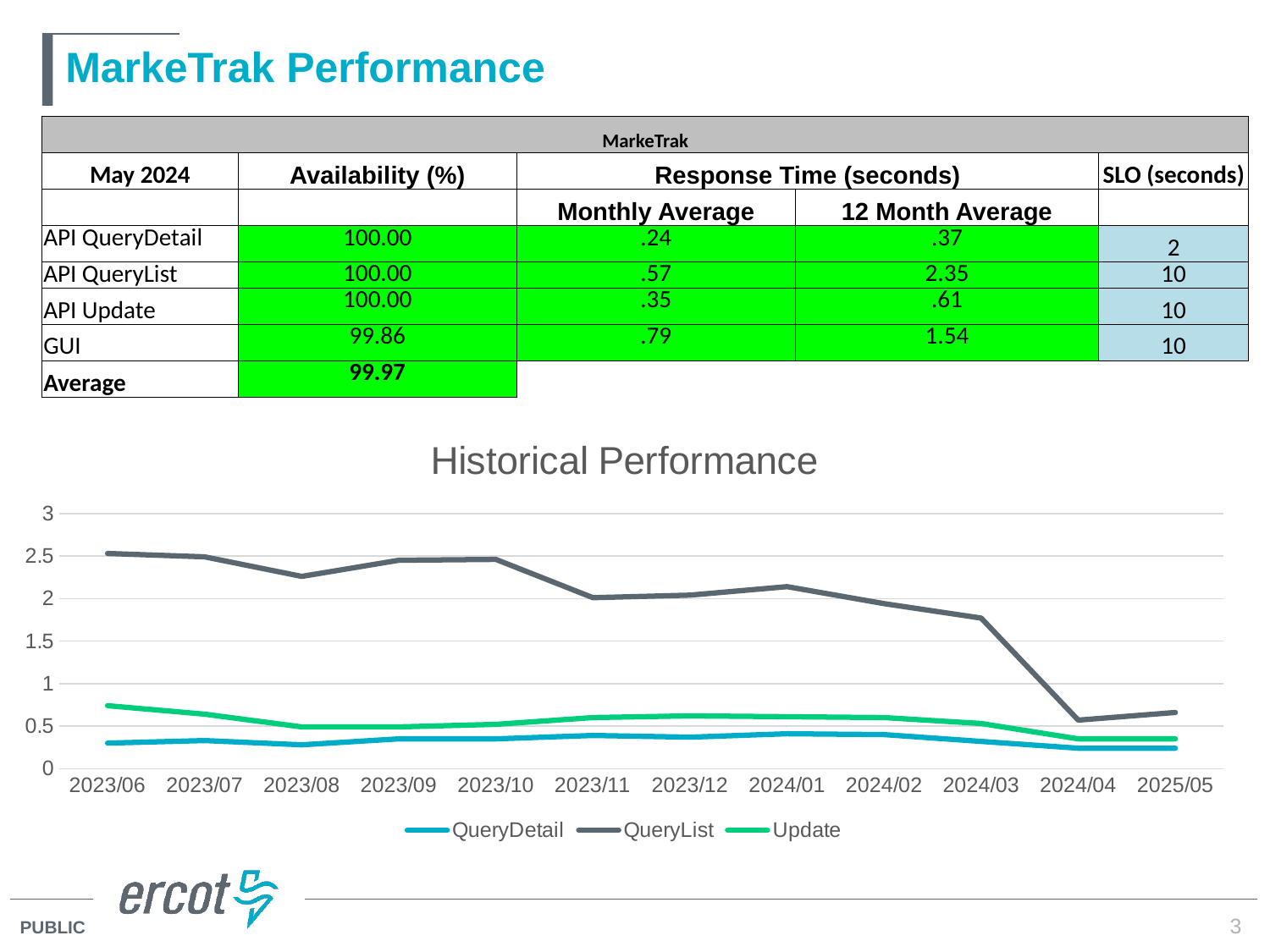
In the Historical Performance chart, is the Update value at 2023/06 greater or less than 0.5? greater In the Historical Performance chart, which series has the higher value at 2023/10, QueryList or QueryDetail? QueryList In the Historical Performance chart, is the QueryDetail value at 2023/06 greater or less than 0.5? less What kind of chart is the Historical Performance chart? line chart In the Historical Performance chart, is the QueryList value at 2024/04 greater or less than 1? less How many points along the x axis does the Historical Performance chart show? 12 How many series does the legend of the Historical Performance chart list? 3 Which series are listed in the legend of the Historical Performance chart? QueryDetail, QueryList, Update In the Historical Performance chart, does the QueryList series rise or fall from 2023/06 to 2025/05? fall In the Historical Performance chart, which series has the highest values across the period shown? QueryList What is the title of the line chart on the slide? Historical Performance